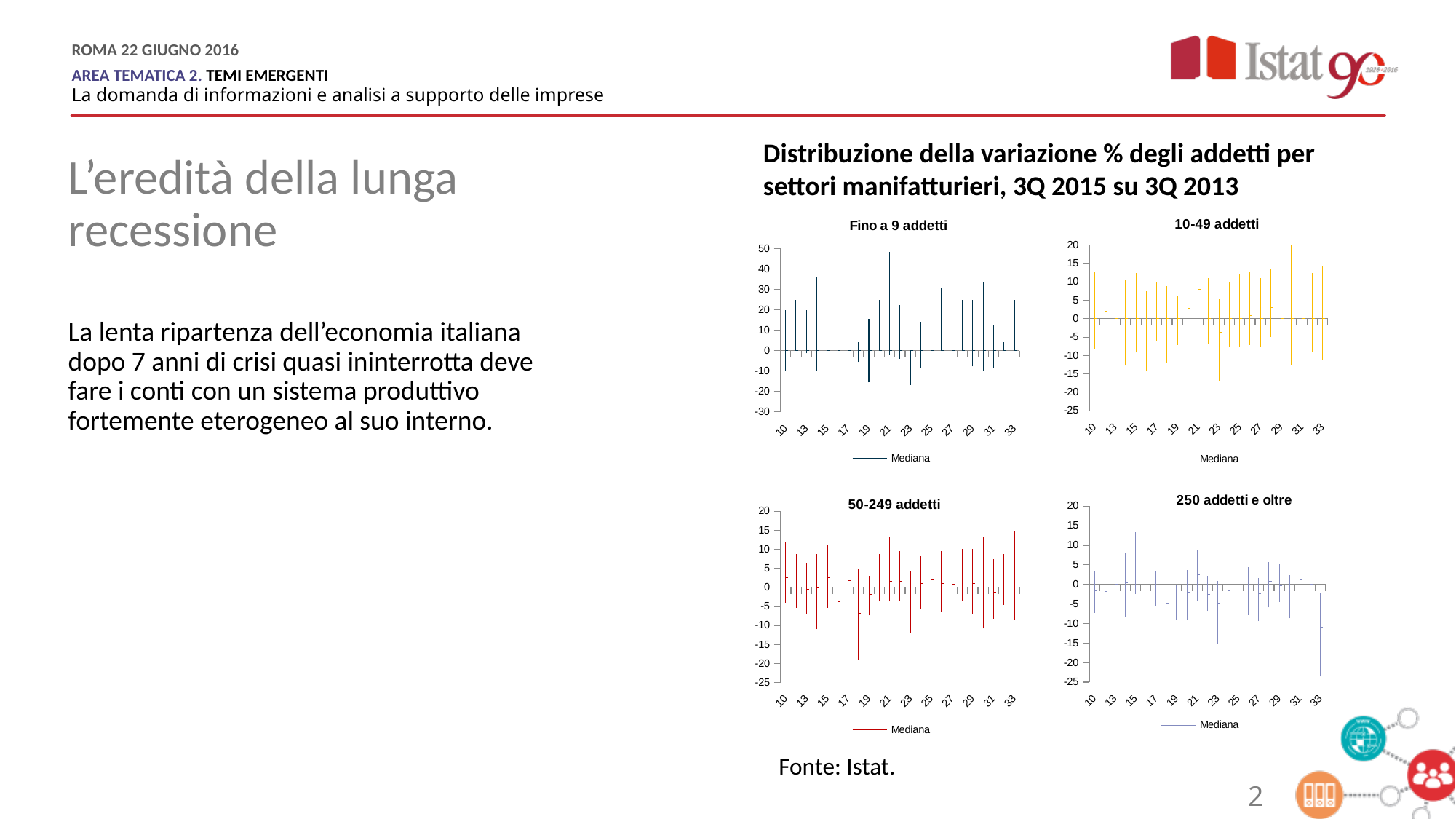
How many separate charts are shown on the slide under the heading 'Distribuzione della variazione % degli addetti per settori manifatturieri'? 4 How many series does the legend of the '10-49 addetti' chart list? 1 In the 'Fino a 9 addetti' chart, what is the single entry listed in the legend? Mediana In the '10-49 addetti' chart, is the upper value for sector 21 greater or less than 15? greater In the '250 addetti e oltre' chart, which sector code has the lowest bottom value? 33 In the 'Fino a 9 addetti' chart, is the upper value for sector 21 greater or less than 40? greater In the 'Fino a 9 addetti' chart, which has the larger upper value: sector 21 or sector 33? 21 In the '250 addetti e oltre' chart, is the bottom value for sector 33 greater or less than -20? less In the 'Fino a 9 addetti' chart, which sector code has the highest upper value? 21 What is the maximum value shown on the y-axis of the 'Fino a 9 addetti' chart? 50